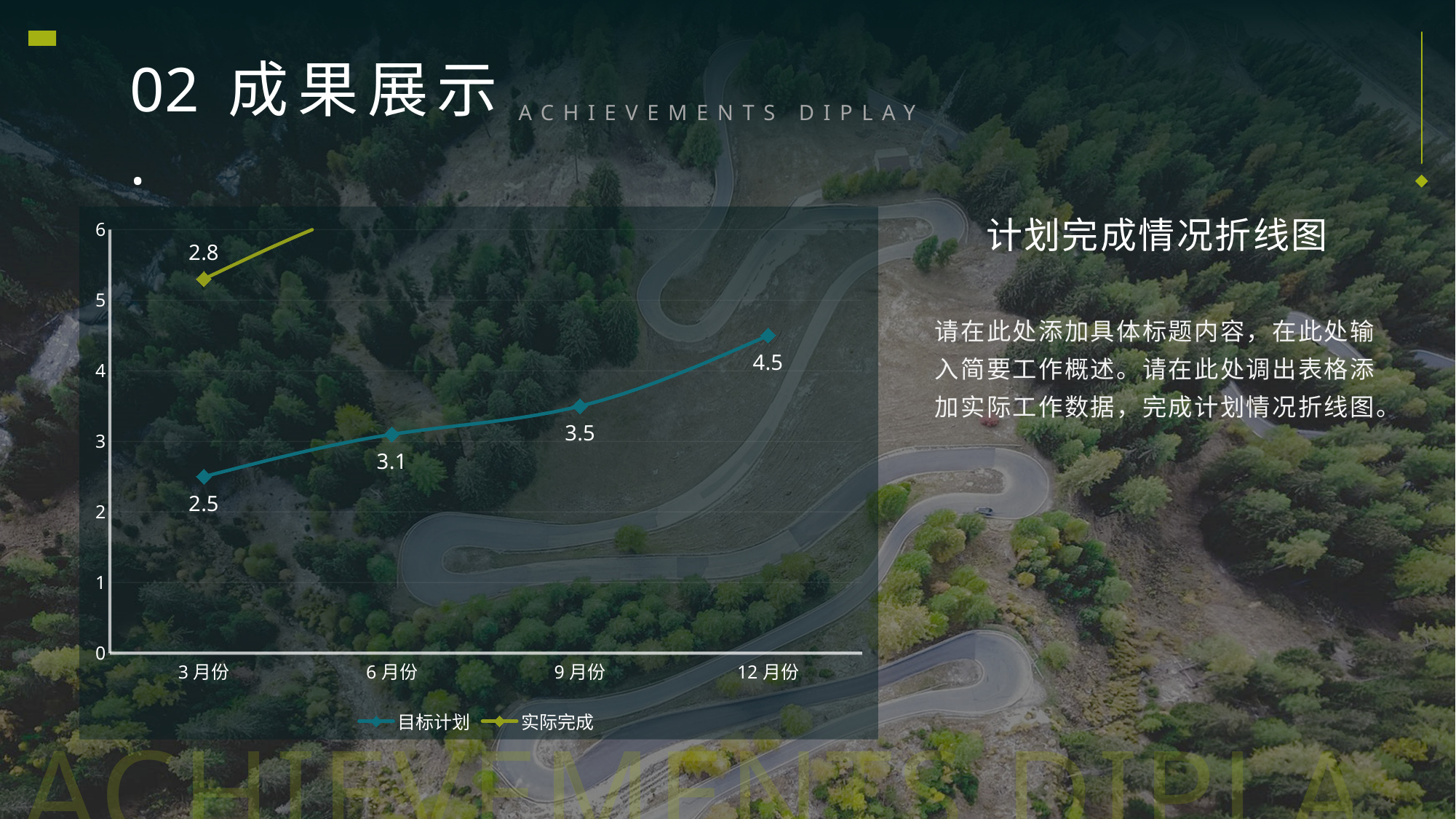
What kind of chart is shown on the slide? line chart How many series does the legend list? 2 What is the value of 目标计划 for 3月份? 2.5 Does the 目标计划 line rise or fall from 3月份 to 12月份? rise What is the value of 目标计划 for 12月份? 4.5 What is the value of 目标计划 for 6月份? 3.1 What is the difference between the 目标计划 values for 12月份 and 3月份? 2 What is the value of 目标计划 for 9月份? 3.5 Which has the larger 目标计划 value, 6月份 or 9月份? 9月份 In which month is the 目标计划 value lowest? 3月份 What is the difference between the 目标计划 values for 9月份 and 6月份? 0.4 In which month is the 目标计划 value highest? 12月份